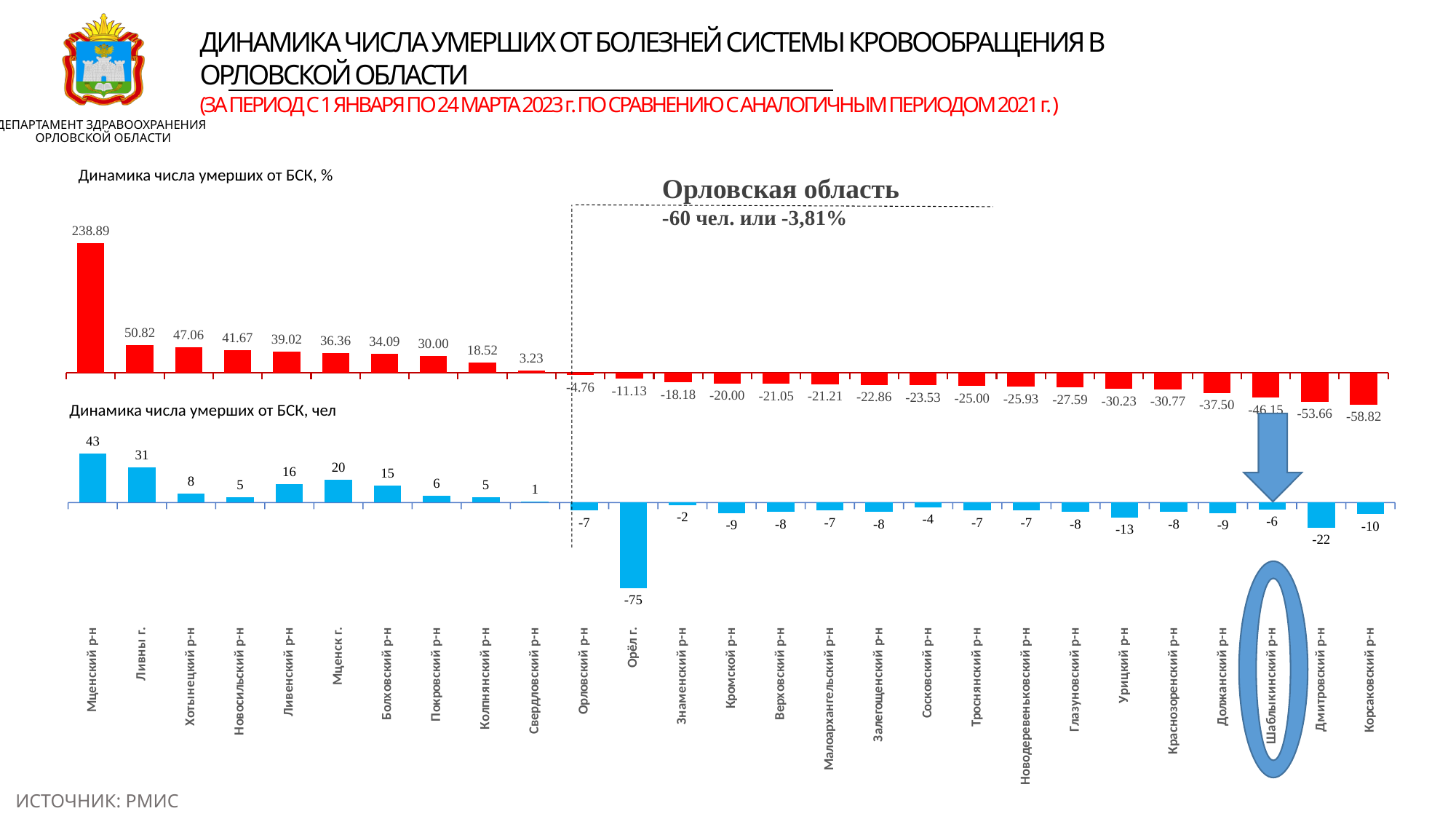
In the top chart (Динамика числа умерших от БСК, %), which category has the highest value? Мценский р-н In the top chart (Динамика числа умерших от БСК, %), what is the value for Корсаковский р-н? -58.82 In the top chart (Динамика числа умерших от БСК, %), which is larger: the value for Ливенский р-н or the value for Мценск г.? Ливенский р-н In the top chart (Динамика числа умерших от БСК, %), what is the value for Мценский р-н? 238.89 In the bottom chart (Динамика числа умерших от БСК, чел), what is the difference between the values for Мценский р-н and Ливны г.? 12 What colour are the bars in the bottom chart (Динамика числа умерших от БСК, чел)? blue In the bottom chart (Динамика числа умерших от БСК, чел), what is the value for Дмитровский р-н? -22 In the bottom chart (Динамика числа умерших от БСК, чел), which category has the lowest value? Орёл г. In the bottom chart (Динамика числа умерших от БСК, чел), what is the value for Орёл г.? -75 What kind of chart is the top chart (Динамика числа умерших от БСК, %)? bar chart How many categories are shown on the x axis of the charts? 27 In the top chart (Динамика числа умерших от БСК, %), do the values rise or fall from left to right along the x axis? fall